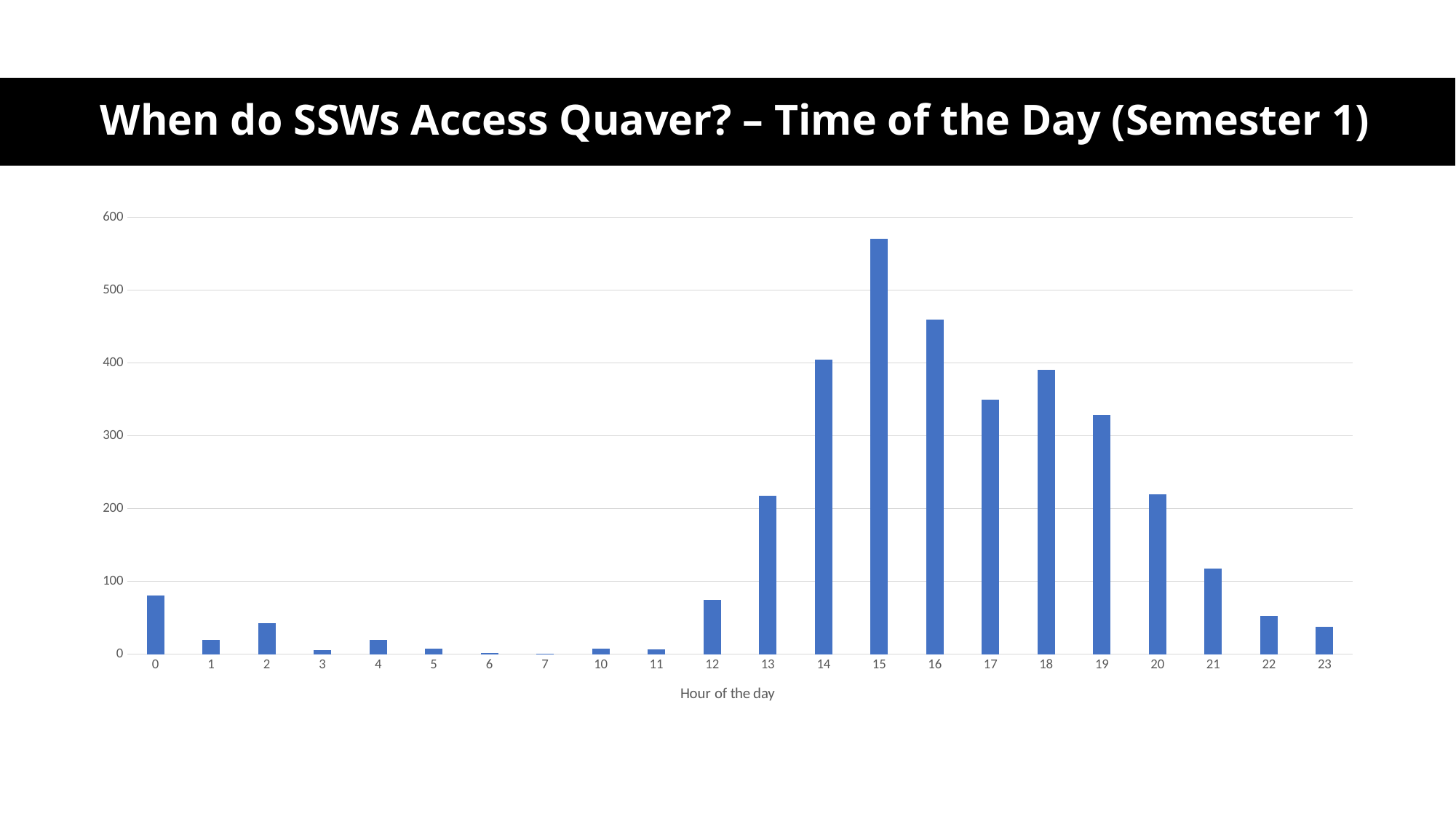
Is the value for hour 0 greater or less than 100? less Is the value for hour 17 greater or less than 400? less How many hour categories are shown on the x axis? 22 Is the value for hour 19 greater or less than 300? greater Which hour of the day has the highest value? 15 What kind of chart is shown on the slide? bar chart Which has the larger value, hour 19 or hour 20? 19 What is the title of the chart? When do SSWs Access Quaver? – Time of the Day (Semester 1) Do the values rise or fall from hour 15 to hour 23? fall What is the label on the x axis of the chart? Hour of the day Which has the larger value, hour 16 or hour 17? 16